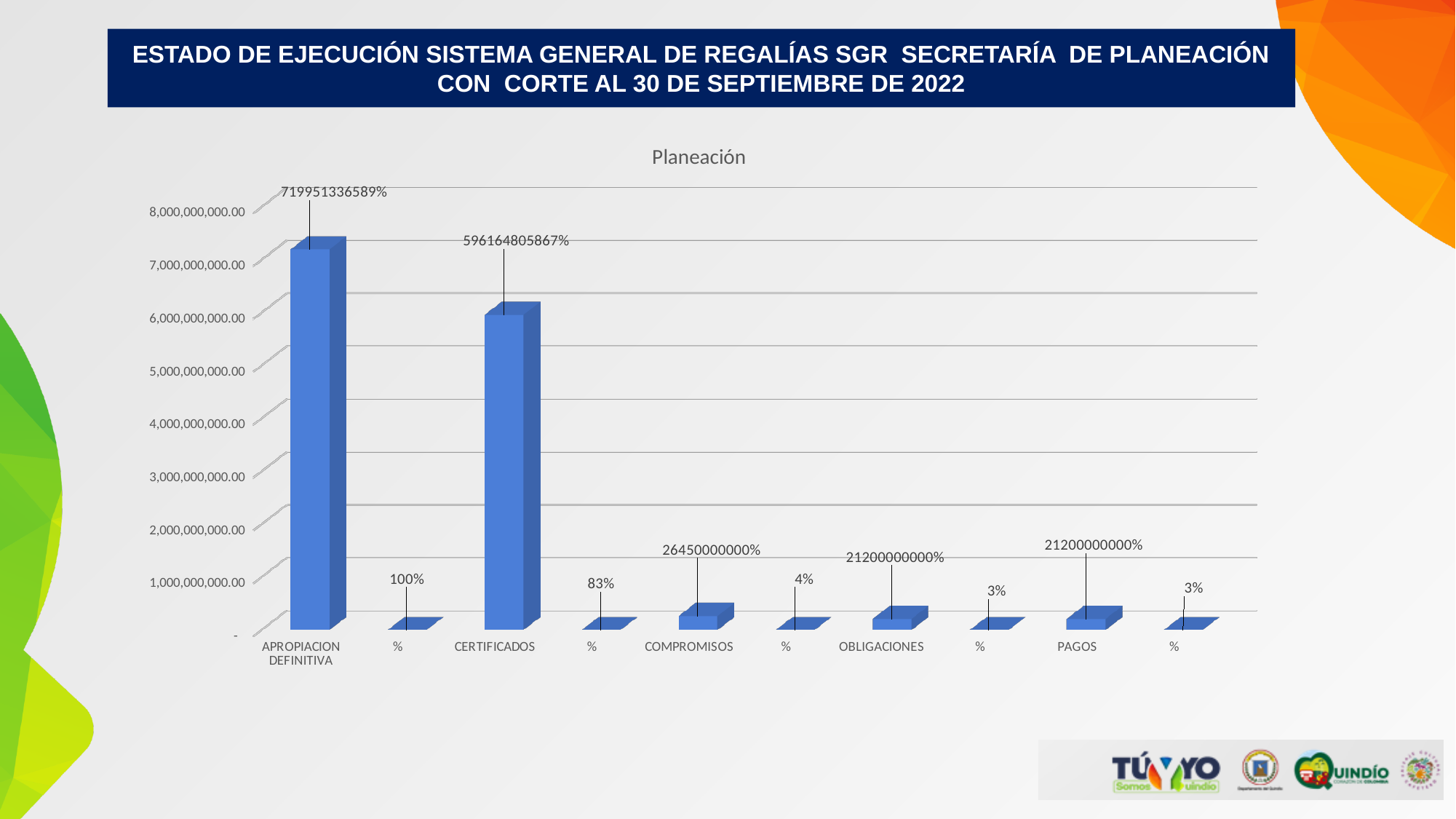
What is the data label on the % bar immediately to the right of CERTIFICADOS? 83% How many bars (categories) are plotted in the chart? 10 What kind of chart is shown on the slide? bar chart What is the difference between the % label after APROPIACION DEFINITIVA (100%) and the % label after CERTIFICADOS (83%)? 17% What is the data label shown for PAGOS? 21200000000% Which is larger, the value for CERTIFICADOS or the value for COMPROMISOS? CERTIFICADOS What is the title of the chart? Planeación What is the data label shown for CERTIFICADOS? 596164805867% What is the data label shown for COMPROMISOS? 26450000000% Is the bar for APROPIACION DEFINITIVA greater or less than 7,000,000,000.00 on the axis? greater What is the data label shown for APROPIACION DEFINITIVA? 719951336589% Which category has the highest bar in the chart? APROPIACION DEFINITIVA